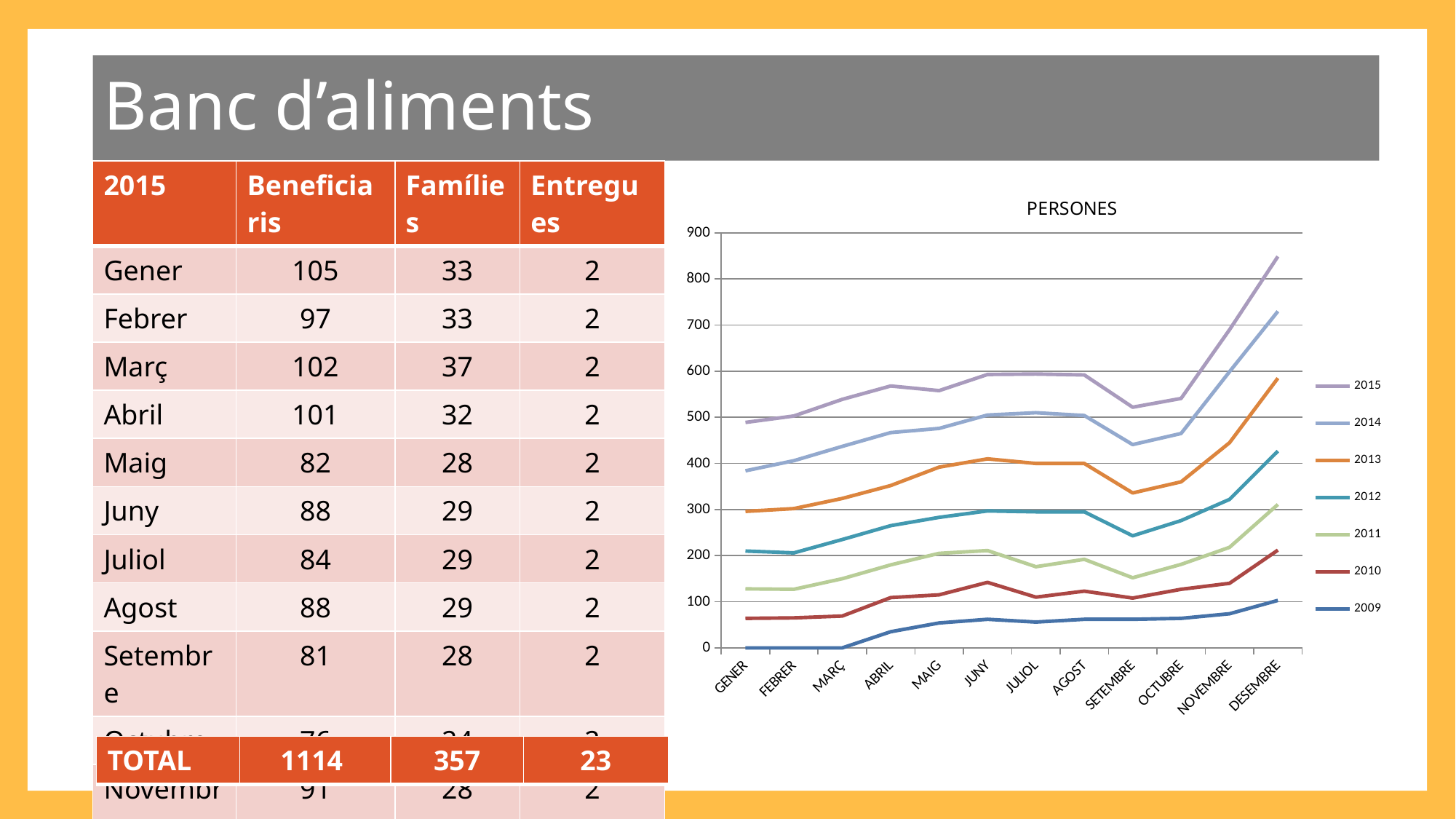
How many months are shown along the x axis of the PERSONES chart? 12 What kind of chart is shown on the slide? line chart How many series does the legend of the PERSONES chart list? 7 Is the value for 2013 in DESEMBRE greater or less than 500? greater Which year's line is the lowest across the chart? 2009 Is the value for 2015 in GENER greater or less than 400? greater Which year's line reaches the highest value in DESEMBRE? 2015 Is the value for 2015 in DESEMBRE greater or less than 800? greater Does the 2015 line rise or fall from SETEMBRE to DESEMBRE? rise In DESEMBRE, which is larger: the value for 2015 or the value for 2009? 2015 What is the title of the chart? PERSONES